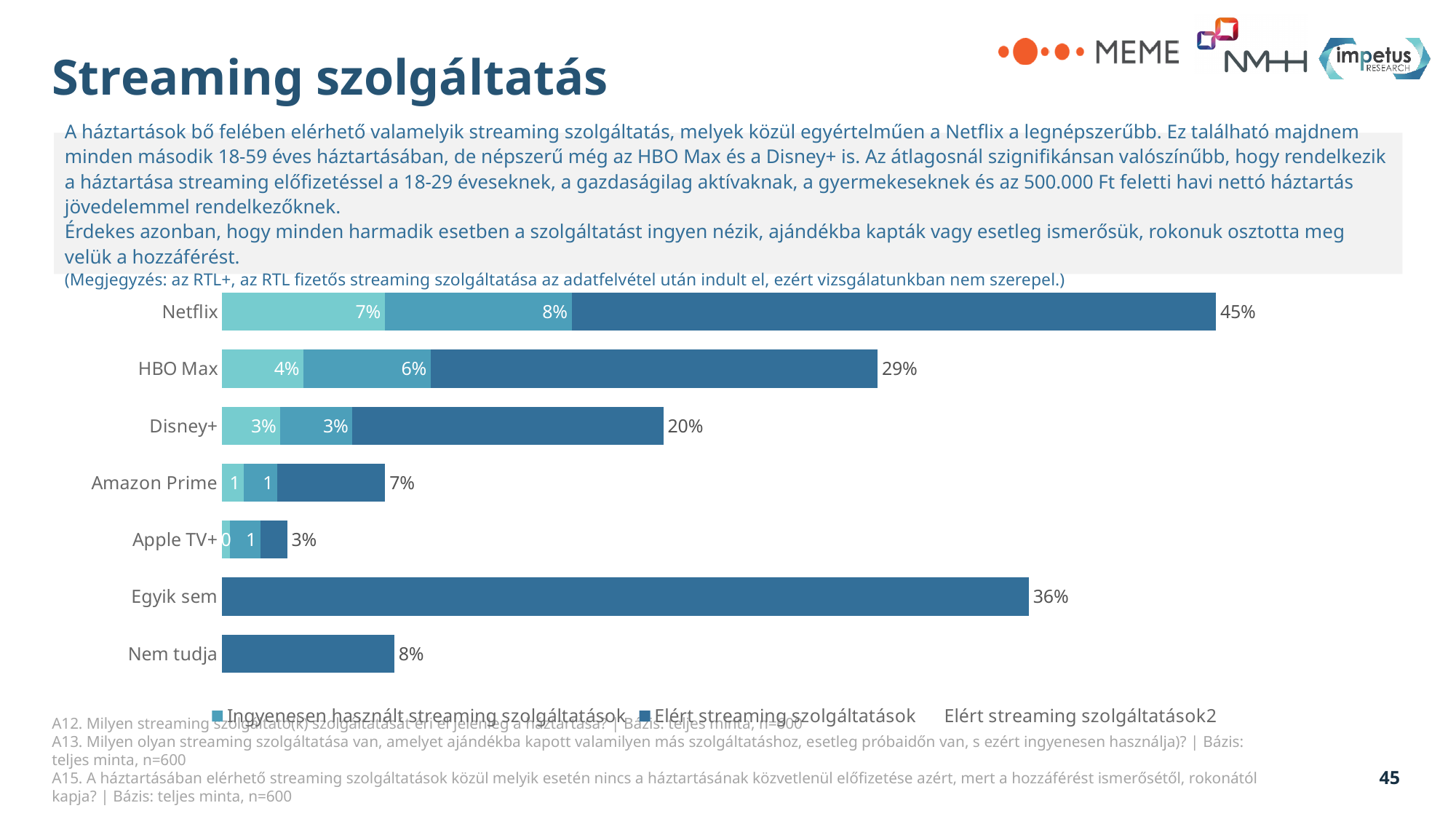
What kind of chart is shown on the slide? bar chart Which category has the shortest bar? Apple TV+ What value is shown at the end of the Netflix bar? 45% What value is shown at the end of the HBO Max bar? 29% How many series does the chart legend list? 3 How many categories are plotted on the chart? 7 What is the 'Ingyenesen használt streaming szolgáltatások' value for Netflix? 8% What is the difference between the end values of the Netflix bar (45%) and the HBO Max bar (29%)? 16 percentage points Which is larger: the end value for 'Egyik sem' or for HBO Max? Egyik sem What value is shown at the end of the 'Egyik sem' bar? 36% Which category has the longest bar? Netflix